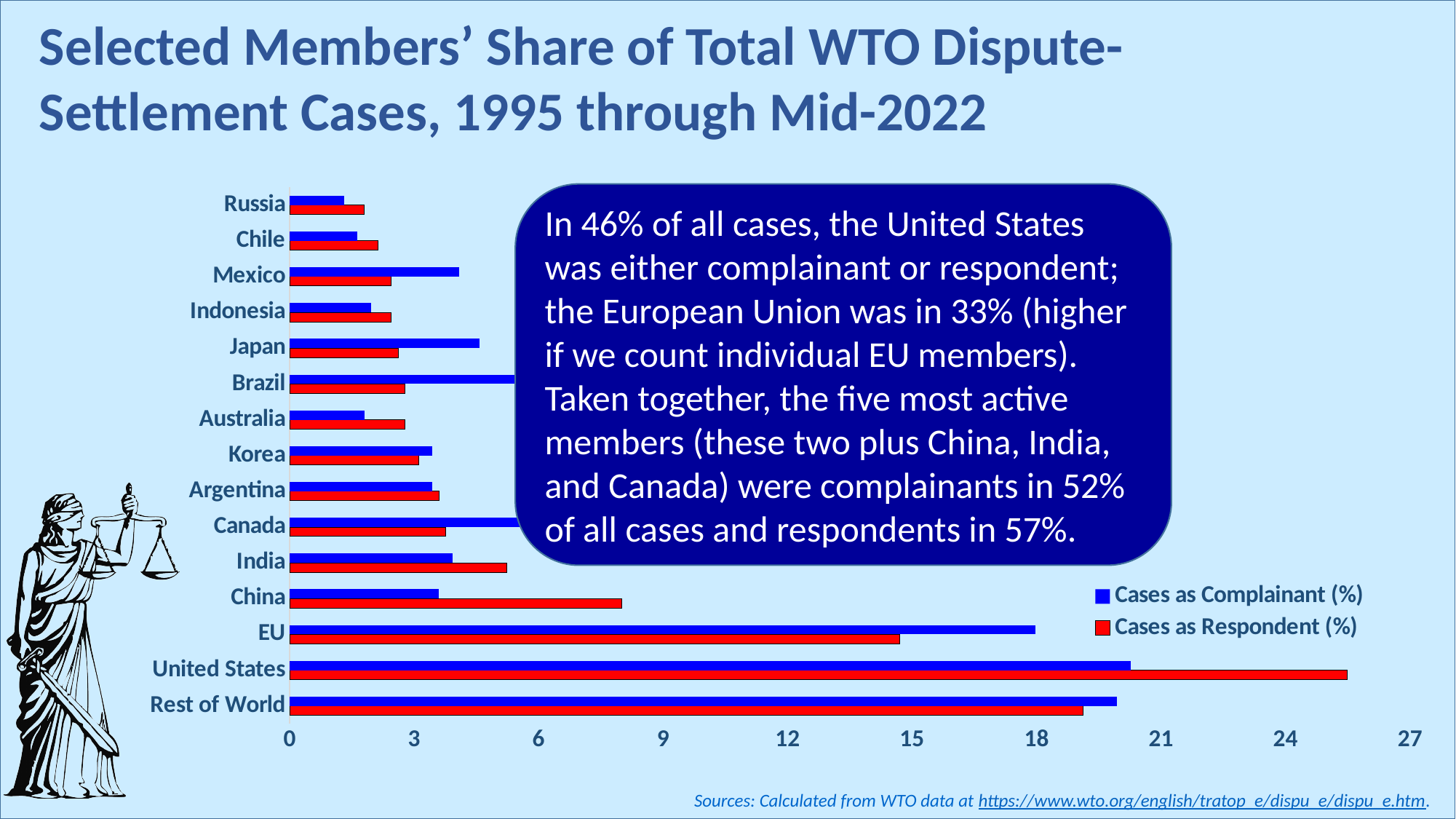
For China, which is larger: Cases as Complainant (%) or Cases as Respondent (%)? Cases as Respondent (%) Is the Cases as Complainant (%) value for Rest of World greater or less than 18? greater Is the Cases as Complainant (%) value for Russia greater or less than 3? less How many members (categories) are plotted on the chart? 15 Is the Cases as Respondent (%) value for China greater or less than 6? greater For the EU, which is larger: Cases as Complainant (%) or Cases as Respondent (%)? Cases as Complainant (%) What kind of chart is shown on the slide? bar chart How many series does the chart's legend list? 2 Which member has the highest value for Cases as Respondent (%)? United States Which colour represents Cases as Respondent (%) in the legend? red